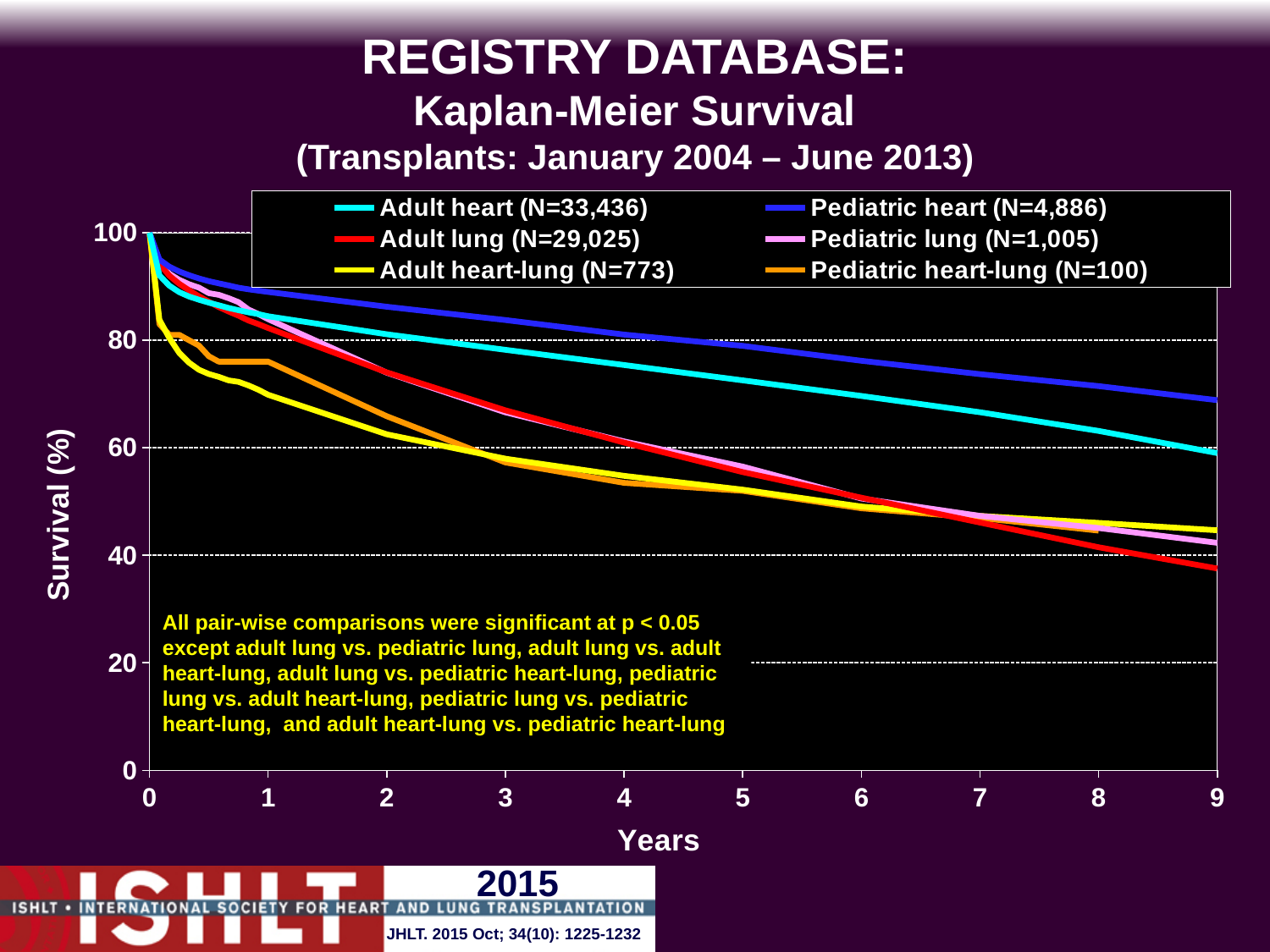
Which series has the highest survival at 9 years? Pediatric heart According to the legend, what is the N for Adult heart? 33,436 At 1 year, which has higher survival: Adult heart-lung or Pediatric heart-lung? Pediatric heart-lung Is the survival for Pediatric heart at 9 years greater or less than 60? greater What is the label of the y-axis? Survival (%) Which series has the lowest survival at 9 years? Adult lung Is the survival for Adult heart at 5 years greater or less than 60? greater Is the survival for Adult lung at 9 years greater or less than 40? less Do the survival curves rise or fall as years increase? Fall How many series does the legend list? 6 What kind of chart is shown on the slide? Line chart At 9 years, which has higher survival: Pediatric heart or Adult heart? Pediatric heart